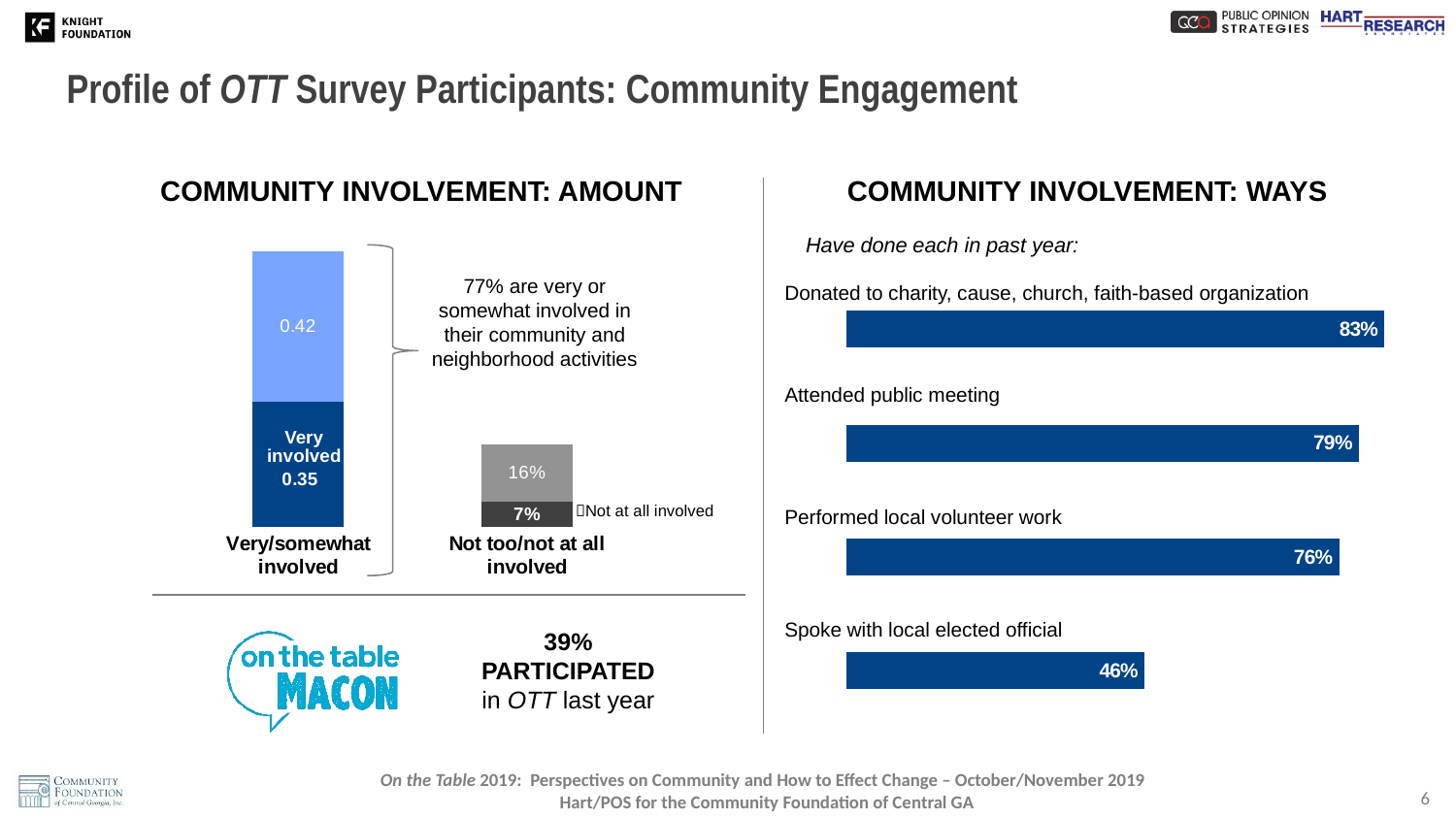
In the COMMUNITY INVOLVEMENT: WAYS chart, what percentage spoke with a local elected official? 46% In the COMMUNITY INVOLVEMENT: WAYS chart, what is the difference in percentage points between attending a public meeting and speaking with a local elected official? 33 In the COMMUNITY INVOLVEMENT: AMOUNT chart, what value is shown for the 'Very involved' segment? 0.35 In the COMMUNITY INVOLVEMENT: WAYS chart, how many activities are listed? 4 What type of chart is the COMMUNITY INVOLVEMENT: WAYS chart? Bar chart In the COMMUNITY INVOLVEMENT: WAYS chart, which activity has the highest percentage? Donated to charity, cause, church, faith-based organization In the COMMUNITY INVOLVEMENT: WAYS chart, what percentage performed local volunteer work? 76% In the COMMUNITY INVOLVEMENT: AMOUNT chart, which stacked bar is taller, 'Very/somewhat involved' or 'Not too/not at all involved'? Very/somewhat involved In the COMMUNITY INVOLVEMENT: WAYS chart, which activity has the lowest percentage? Spoke with local elected official In the COMMUNITY INVOLVEMENT: AMOUNT chart, what percentage is labeled as 'Not at all involved'? 7% In the COMMUNITY INVOLVEMENT: WAYS chart, what percentage donated to charity, cause, church, or faith-based organization? 83% In the COMMUNITY INVOLVEMENT: AMOUNT chart, what is the total of the 'Not too/not at all involved' stacked bar? 23%